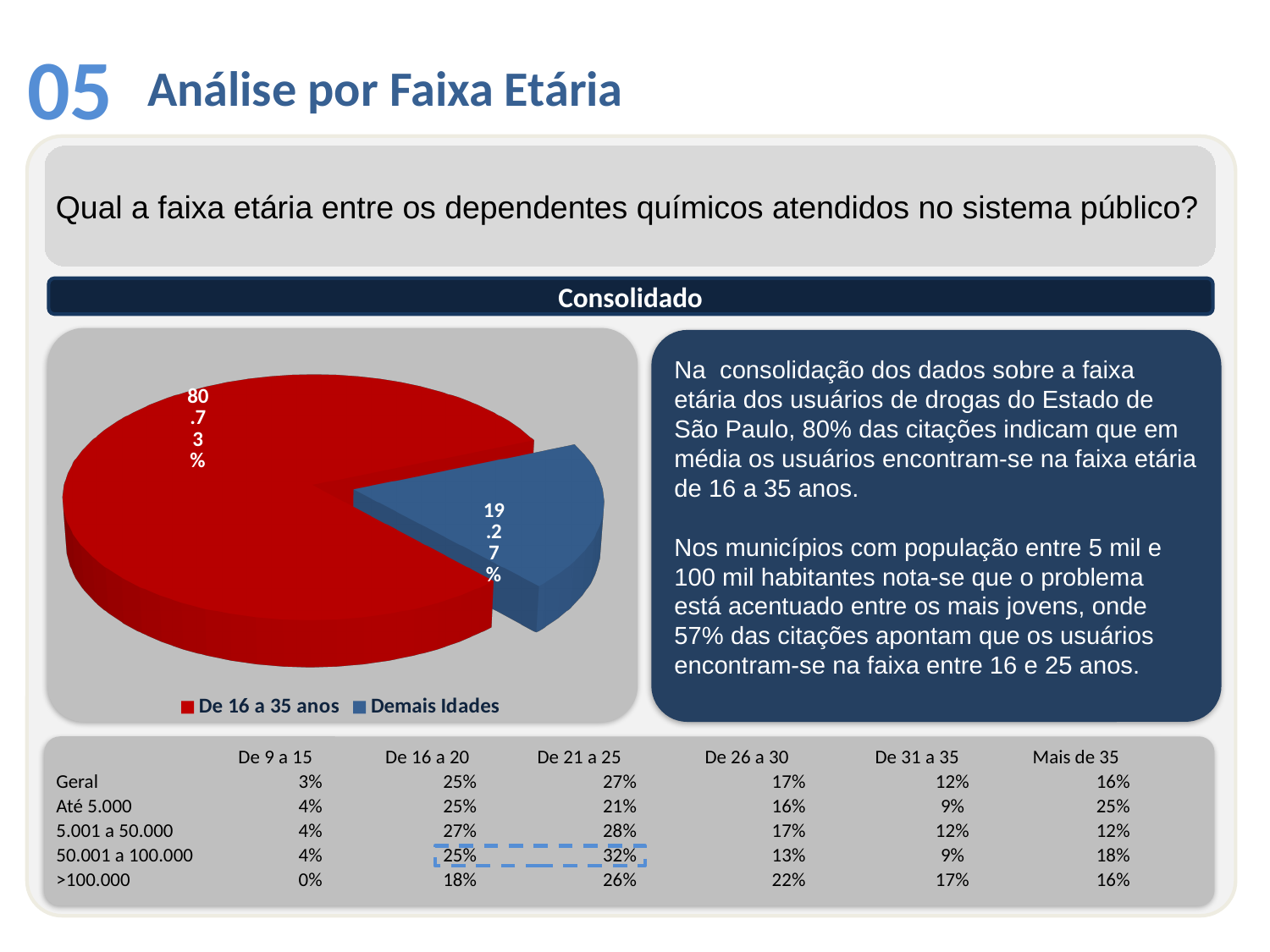
Which is larger in the pie chart, "De 16 a 35 anos" or "Demais Idades"? De 16 a 35 anos What colour is the "De 16 a 35 anos" slice in the pie chart? red How many entries does the pie chart's legend list? 2 How many slices does the pie chart have? 2 What share of the pie chart does the "Demais Idades" slice represent? 19.27% What is the difference between the "De 16 a 35 anos" and "Demais Idades" slices of the pie chart? 61.46% What kind of chart is shown under the "Consolidado" heading? pie chart What colour is the "Demais Idades" slice in the pie chart? blue What is the value shown for the "De 16 a 35 anos" slice of the pie chart? 80.73% What is the value shown for the "Demais Idades" slice of the pie chart? 19.27% Which slice of the pie chart is the smallest? Demais Idades Which slice of the pie chart is the largest? De 16 a 35 anos